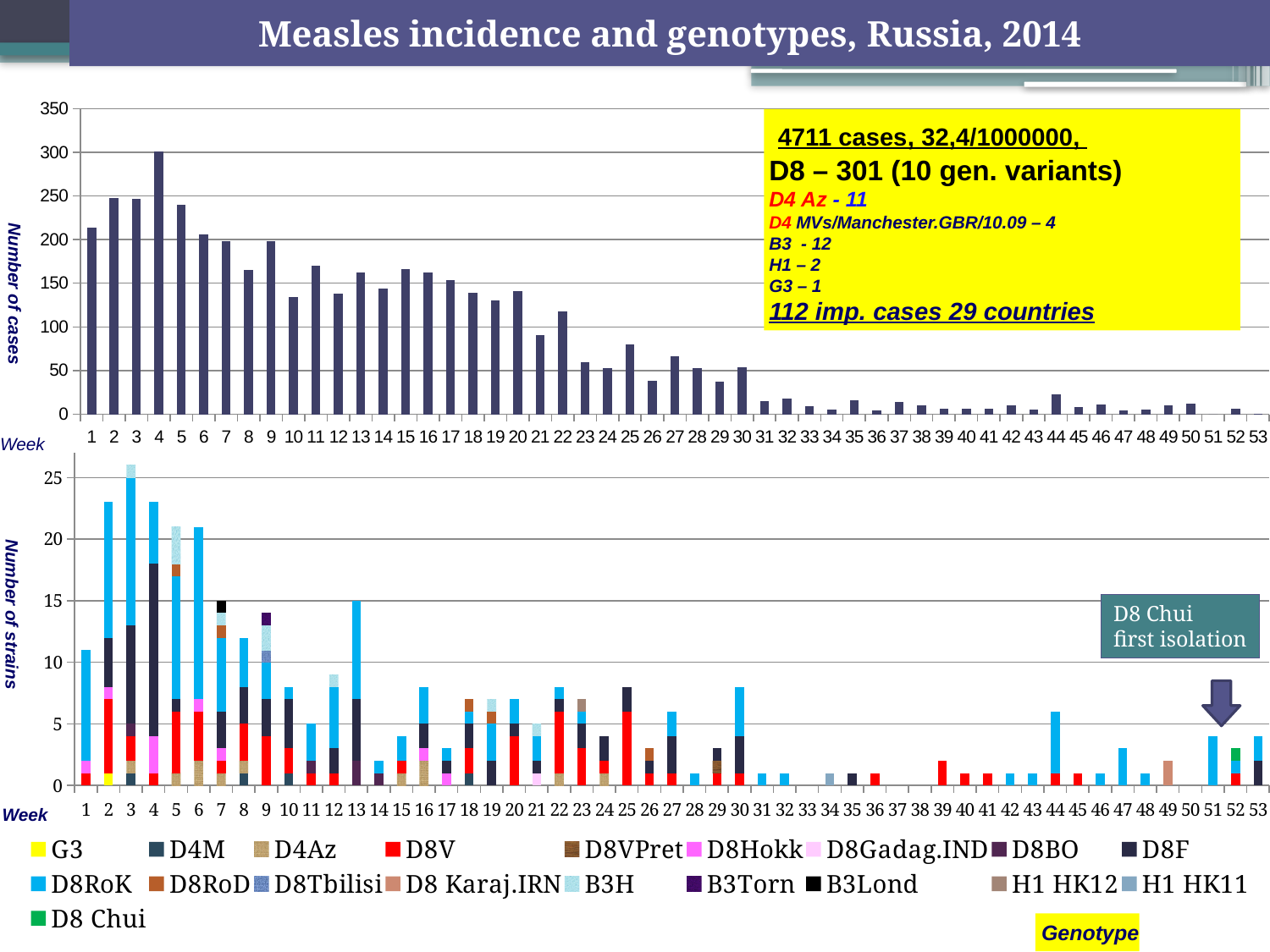
In the top chart (Number of cases), do the values generally rise or fall from week 4 to week 53? fall How many genotype series does the legend of the bottom chart (Number of strains) list? 19 In the top chart (Number of cases), is the value for week 1 greater or less than 200? greater In the top chart (Number of cases), is the value for week 30 greater or less than 100? less In the top chart (Number of cases), which week has the highest number of cases? Week 4 In the bottom chart (Number of strains), which week has the highest total number of strains? Week 3 In the top chart (Number of cases), which week has more cases, week 2 or week 22? Week 2 What kind of chart is the top chart (Number of cases)? bar chart In the top chart (Number of cases), is the value for week 4 greater or less than 250? greater How many weeks are shown on the x axis of the top chart (Number of cases)? 53 What is the y-axis label of the top chart? Number of cases